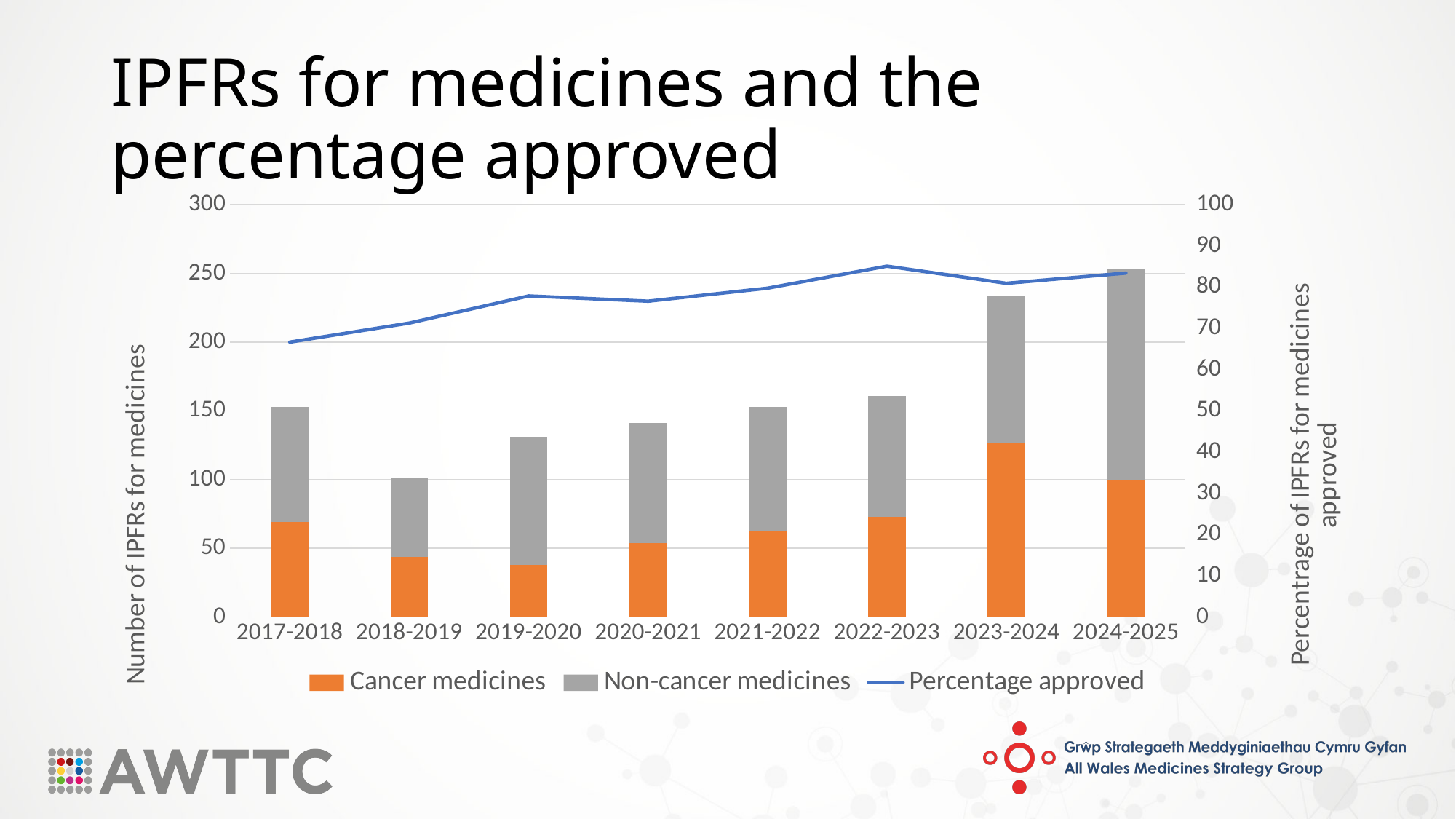
Is the number of IPFRs for cancer medicines in 2023-2024 greater or less than 100? greater Is the total number of IPFRs for medicines in 2023-2024 greater or less than 200? greater Is the total number of IPFRs for medicines in 2018-2019 greater or less than 150? less Which year has the highest number of IPFRs for cancer medicines? 2023-2024 How many series does the legend list? 3 How many financial-year categories are shown on the x axis? 8 Which year has the shortest stacked bar (lowest total number of IPFRs for medicines)? 2018-2019 What kind of chart is shown on the slide? A stacked bar chart with a line Which colour represents cancer medicines in the chart? Orange Which year has the tallest stacked bar (highest total number of IPFRs for medicines)? 2024-2025 Does the percentage of IPFRs approved generally rise or fall from 2017-2018 to 2024-2025? rise